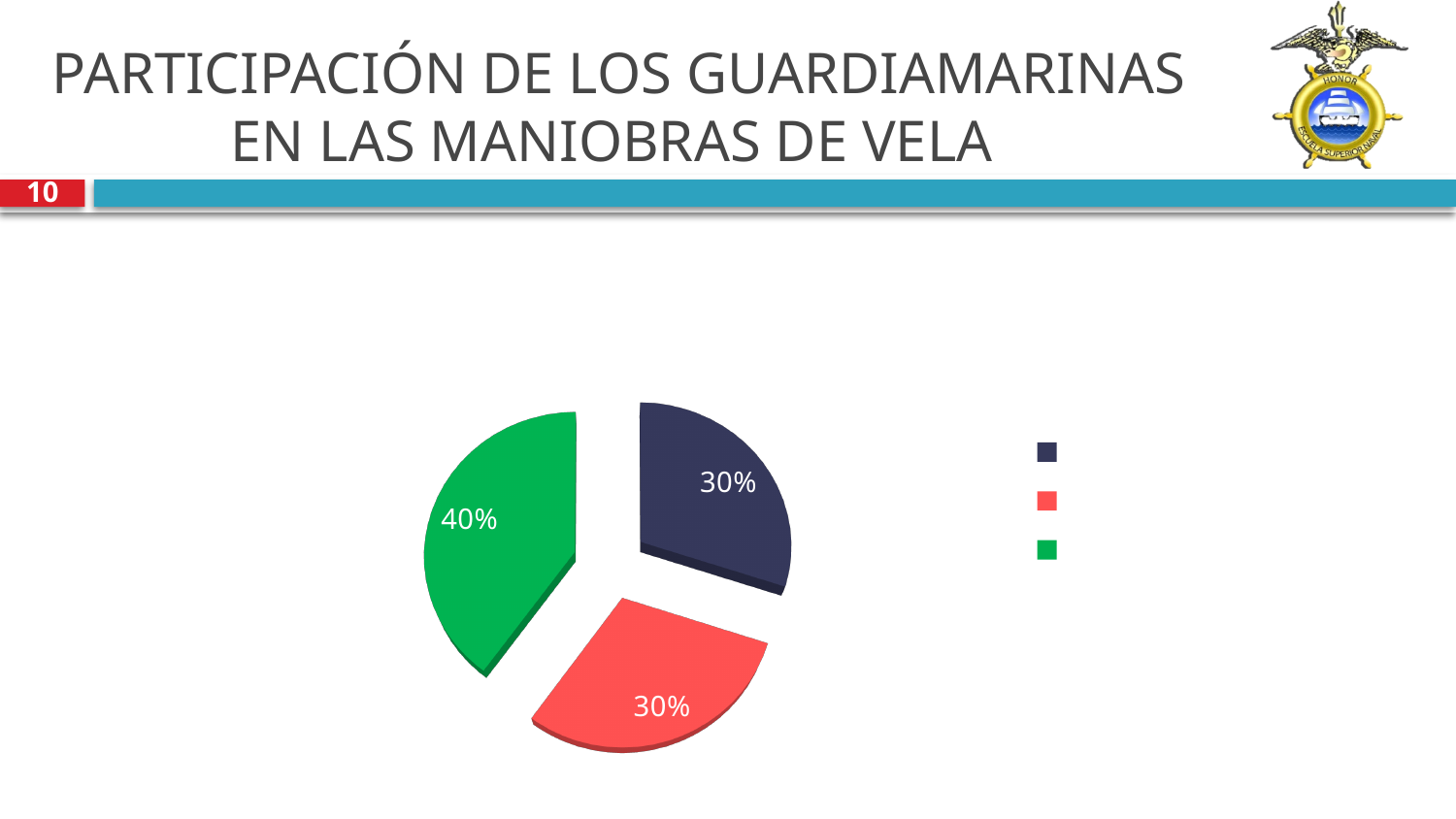
What percentage is shown on the green slice of the pie chart? 40% Which is larger in the pie chart, the green slice or the dark blue slice? green What percentage is shown on the dark blue slice of the pie chart? 30% What percentage is shown on the red slice of the pie chart? 30% What share of the pie does the green slice represent? 40% What is the title of the slide containing the pie chart? PARTICIPACIÓN DE LOS GUARDIAMARINAS EN LAS MANIOBRAS DE VELA Which colour slice is the largest in the pie chart? green Do the dark blue and red slices of the pie chart have the same value? yes How many slices does the pie chart have? 3 What is the difference between the green slice and the red slice in the pie chart? 10% How many entries does the legend of the pie chart list? 3 What kind of chart is shown on the slide? pie chart